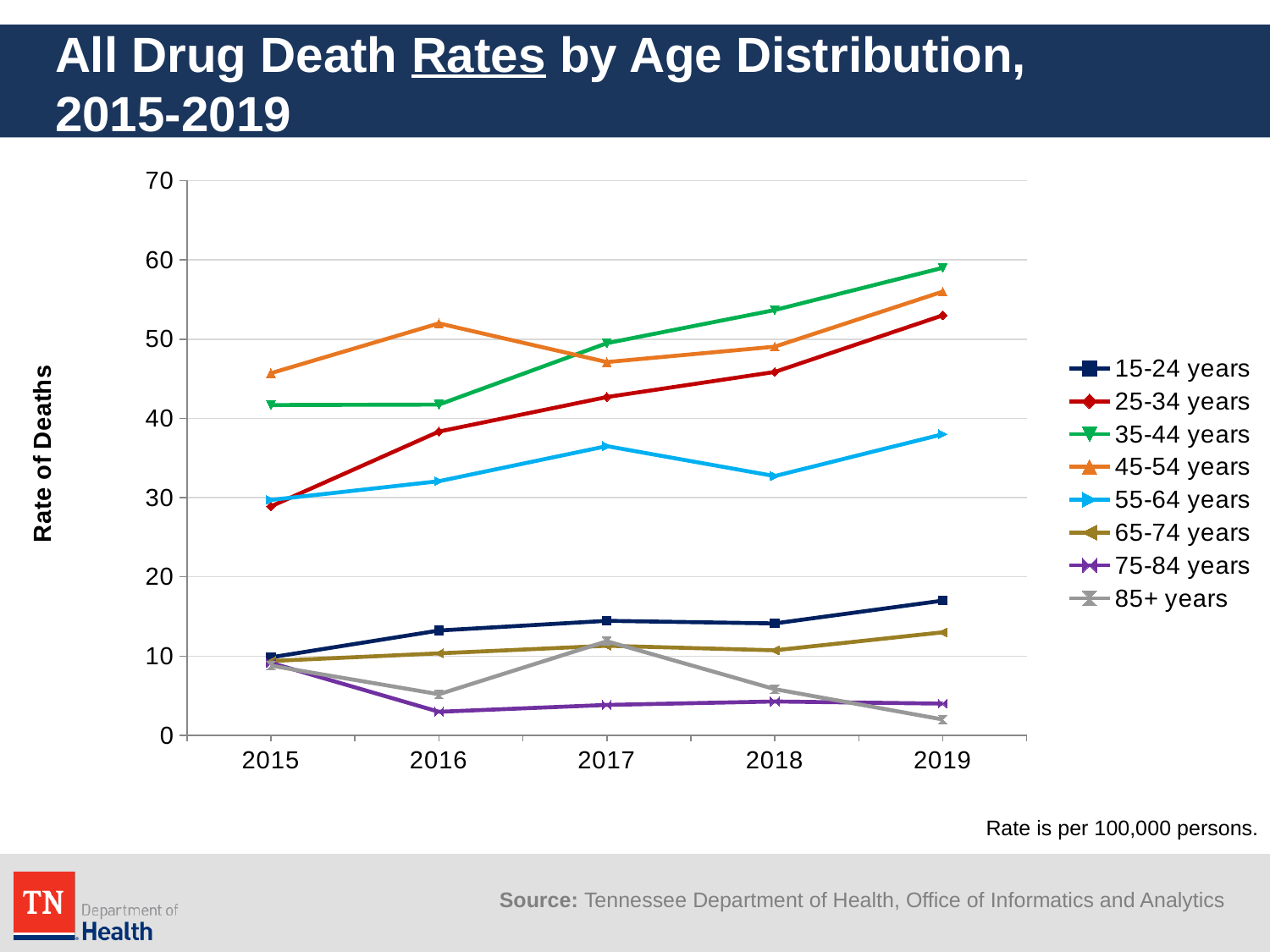
How many series does the legend list? 8 Which age group has the lowest rate of deaths in 2019? 85+ years Which age group has the highest rate of deaths in 2015? 45-54 years How many years are plotted along the x axis? 5 Which age group has the highest rate of deaths in 2019? 35-44 years Is the value for 35-44 years in 2019 greater or less than 50? greater Does the rate of deaths for 25-34 years rise or fall from 2015 to 2019? rise What kind of chart is shown on the slide? line chart In 2016, which is larger: the value for 45-54 years or the value for 35-44 years? 45-54 years Is the value for 25-34 years in 2016 greater or less than 40? less What is the title of the y axis? Rate of Deaths Is the value for 15-24 years in 2019 greater or less than 10? greater